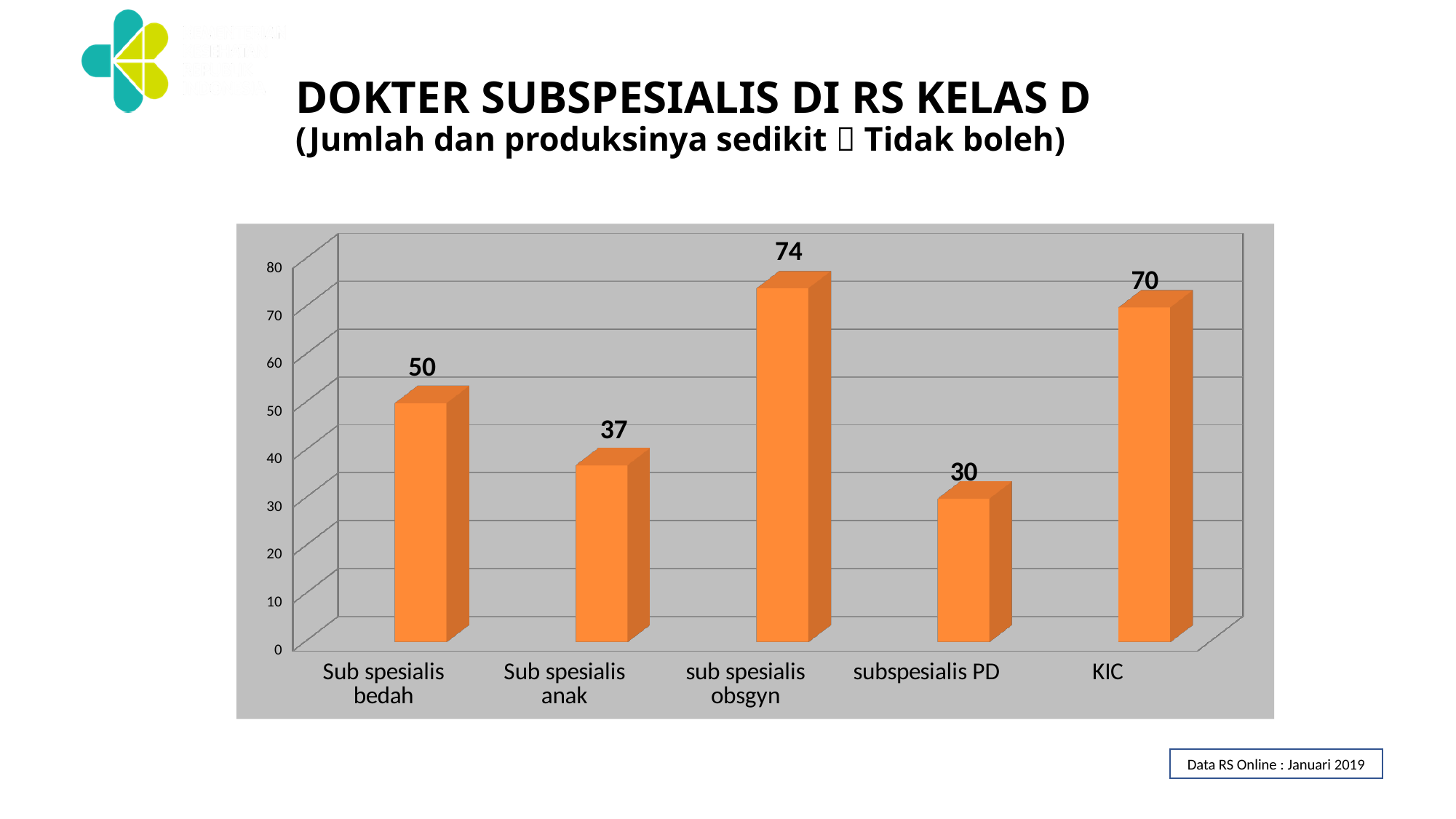
What is the value for sub spesialis obsgyn? 74 What is the value for subspesialis PD? 30 What is the value for KIC? 70 Which category has the highest value? sub spesialis obsgyn What is the data source noted on the slide? Data RS Online : Januari 2019 Which is larger, the value for Sub spesialis bedah or Sub spesialis anak? Sub spesialis bedah Which category has the lowest value? subspesialis PD What kind of chart is shown on the slide? Bar chart What is the value for Sub spesialis bedah? 50 How many categories are shown in the chart? 5 What is the difference between the values for sub spesialis obsgyn and KIC? 4 What is the value for Sub spesialis anak? 37